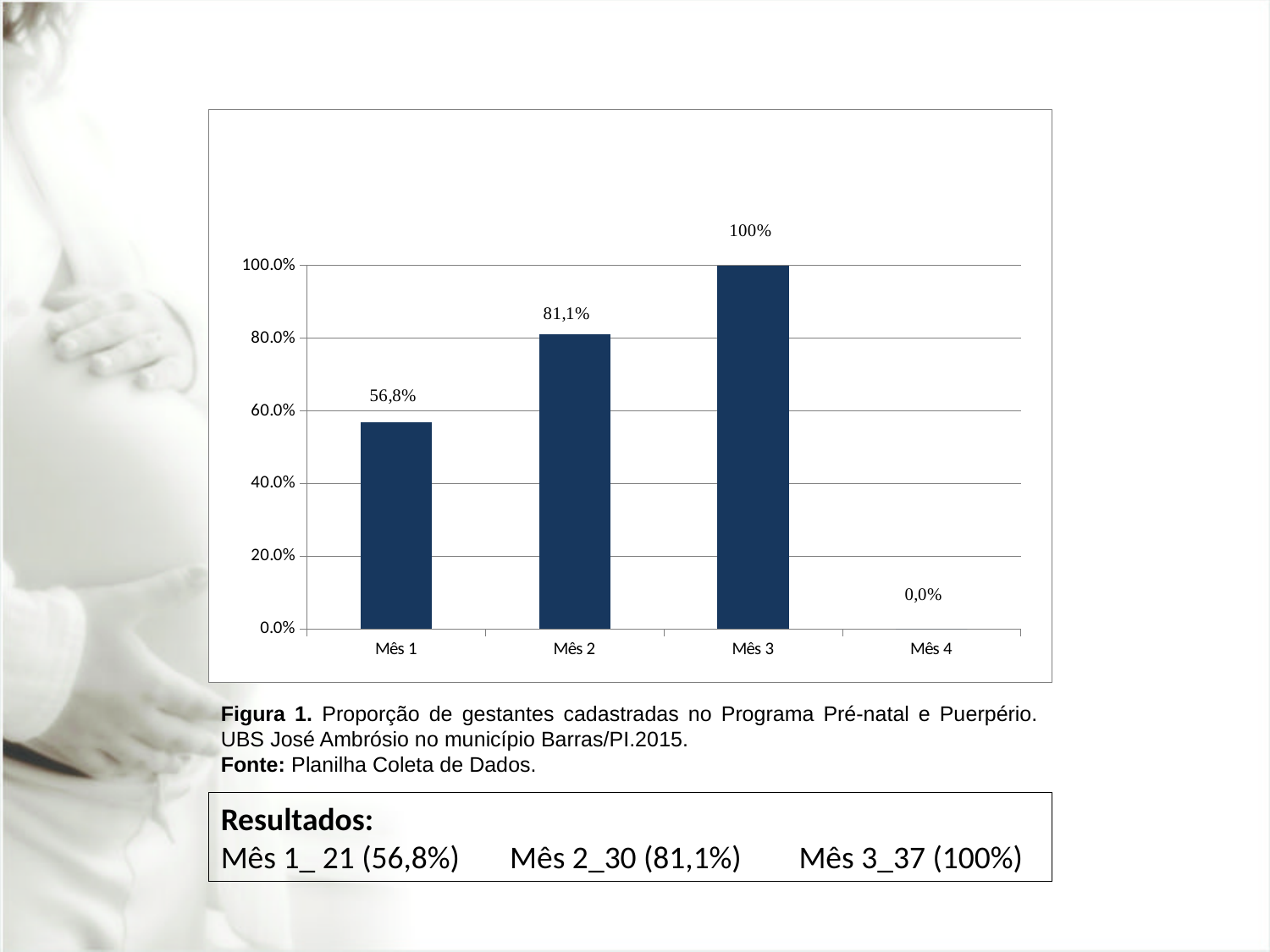
What is the value for Mês 3? 100% Which month has the highest value? Mês 3 Which is larger, the value for Mês 2 or the value for Mês 1? Mês 2 What is the difference between the values for Mês 2 and Mês 1? 24,3 percentage points What kind of chart is shown? Bar chart What is the value for Mês 1? 56,8% What is the difference between the values for Mês 3 and Mês 1? 43,2 percentage points What is the value for Mês 2? 81,1% Which month has the lowest value? Mês 4 How many months are shown on the x axis? 4 What is the value for Mês 4? 0,0% Do the values rise or fall from Mês 1 to Mês 3? Rise